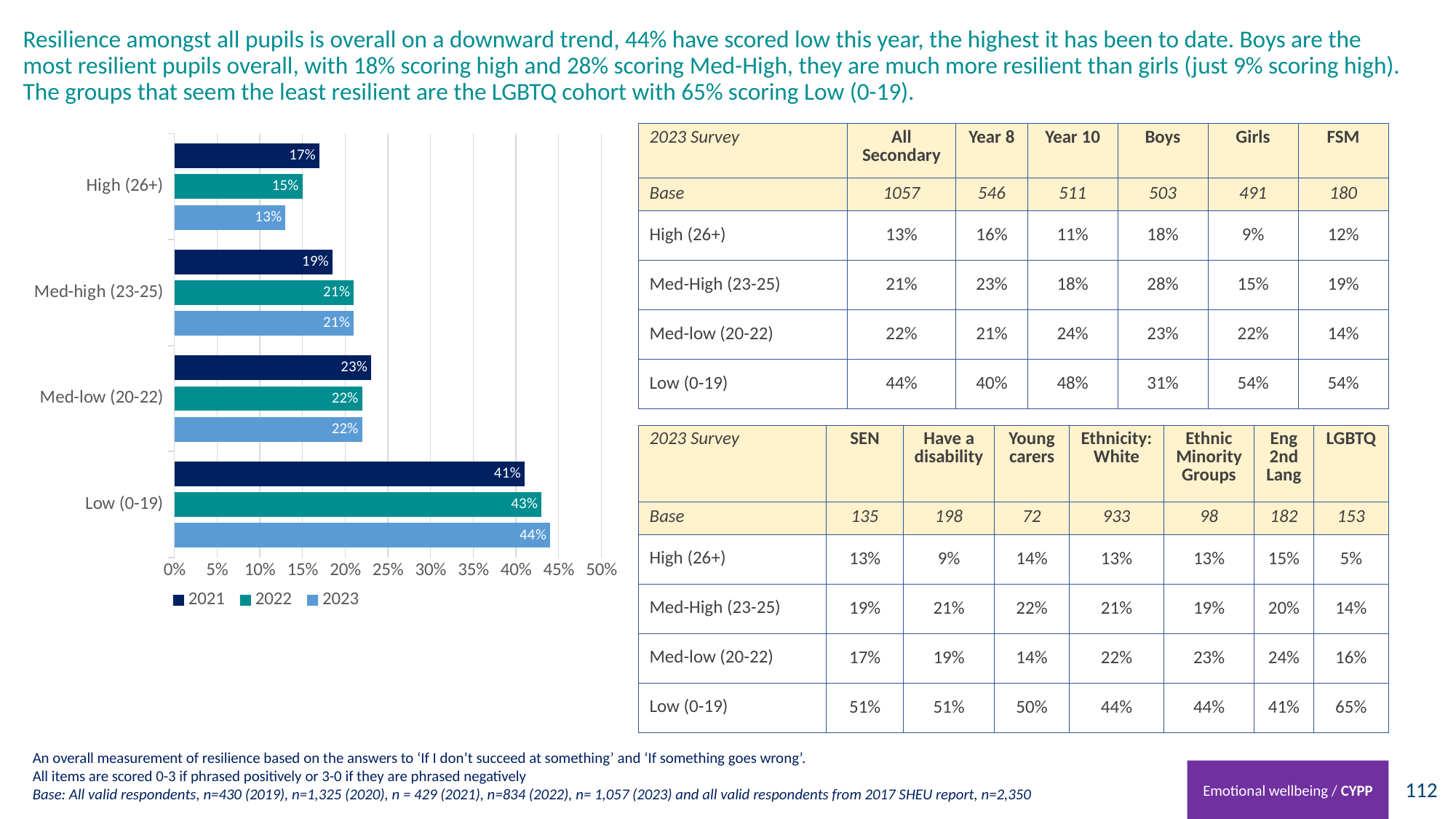
What is the 2022 value for Med-high (23-25)? 21% Which series is shown in the darkest blue colour in the legend? 2021 What is the difference between the 2021 and 2023 values for High (26+)? 4% What is the 2023 value for Low (0-19)? 44% What is the 2021 value for High (26+)? 17% Does the 2023 value for High (26+) rise or fall compared with 2021? fall How many series does the chart legend list? 3 Which category has the highest 2023 value? Low (0-19) How many categories are shown on the chart? 4 Which is larger for Low (0-19): the 2021 value or the 2023 value? 2023 Which category has the lowest 2023 value? High (26+) What kind of chart is shown on the slide? bar chart